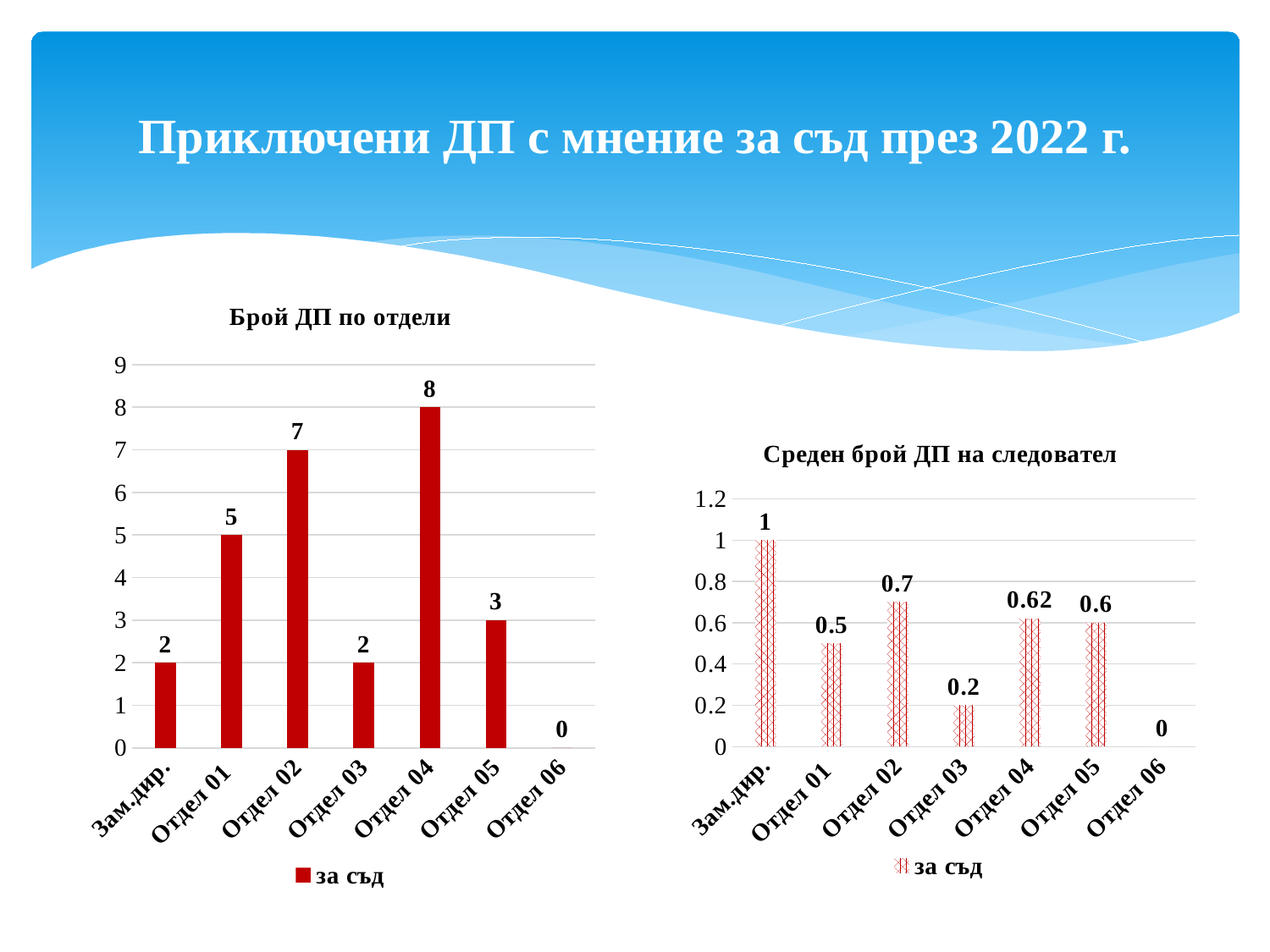
In the chart "Брой ДП по отдели", what is the difference between the values for Отдел 02 and Отдел 01? 2 In the chart "Среден брой ДП на следовател", what is the value for Отдел 04? 0.62 In the chart "Среден брой ДП на следовател", what is the legend entry? за съд In the chart "Брой ДП по отдели", what is the value for Отдел 04? 8 In the chart "Среден брой ДП на следовател", which category has the highest value? Зам.дир. In the chart "Среден брой ДП на следовател", what is the value for Зам.дир.? 1 In the chart "Брой ДП по отдели", how many categories are shown on the x axis? 7 In the chart "Брой ДП по отдели", which category has the highest value? Отдел 04 In the chart "Брой ДП по отдели", which category has the lowest value? Отдел 06 In the chart "Брой ДП по отдели", what type of chart is used? bar chart In the chart "Среден брой ДП на следовател", which is larger, the value for Отдел 02 or the value for Отдел 05? Отдел 02 In the chart "Среден брой ДП на следовател", how many series does the legend list? 1